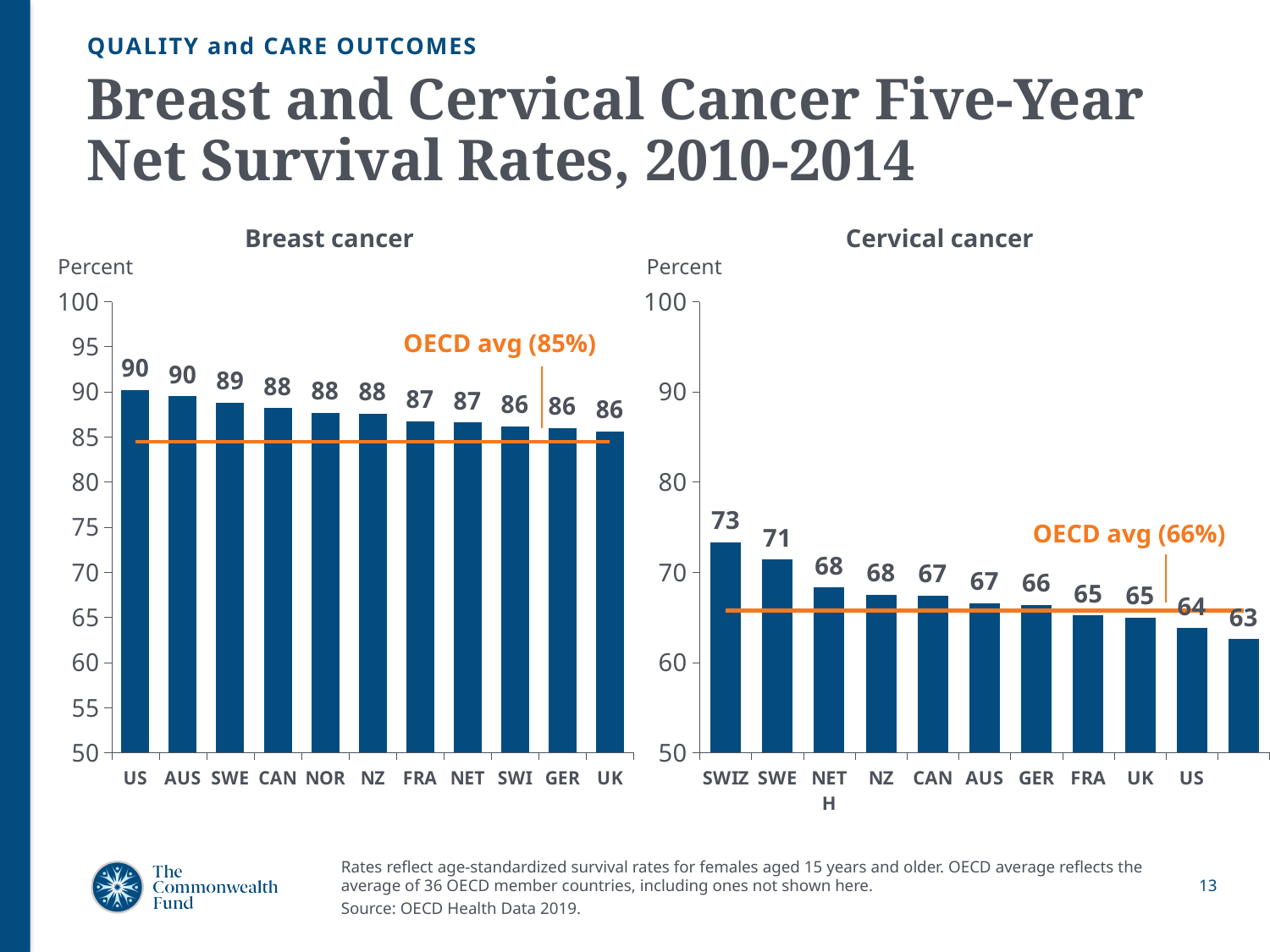
In the Cervical cancer chart, what is the value for SWE? 71 In the Cervical cancer chart, which is larger, the value for NZ or the value for FRA? NZ In the Breast cancer chart, what is the difference between the values for US and UK? 4 What kind of chart is the Breast cancer chart? bar chart In the Breast cancer chart, what is the value for CAN? 88 In the Cervical cancer chart, do the values rise or fall from left to right? fall In the Breast cancer chart, what is the value for FRA? 87 In the Cervical cancer chart, what is the value for GER? 66 In the Cervical cancer chart, which labeled country has the highest value? SWIZ In the Breast cancer chart, how many countries are shown? 11 What OECD average is marked on the Cervical cancer chart? 66% In the Cervical cancer chart, what is the difference between the values for SWIZ and US? 9